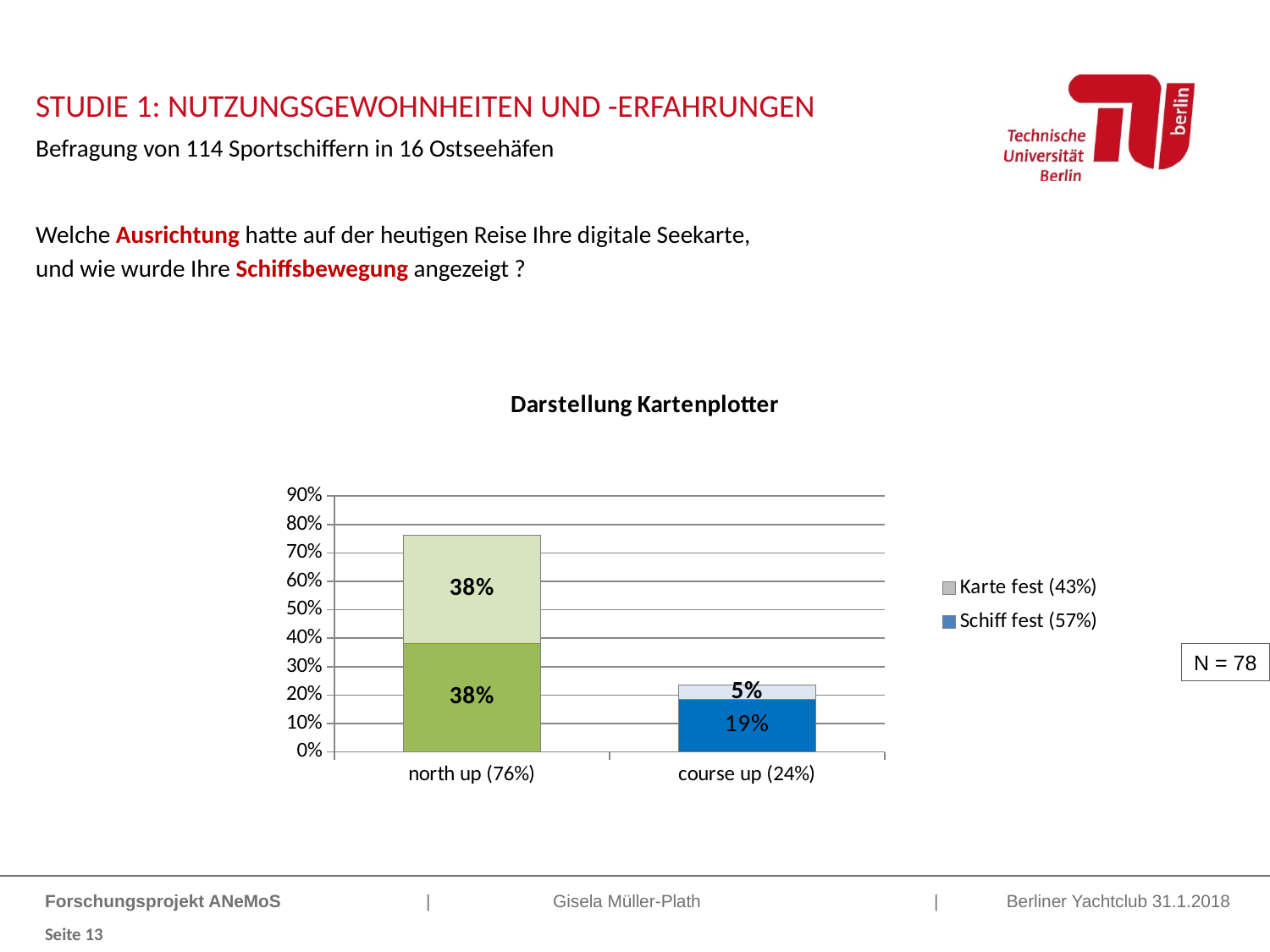
What sample size (N) is stated next to the chart? N = 78 What is the value of the "Schiff fest" segment for "course up"? 19% How many categories are shown on the x axis? 2 What is the value of the "Karte fest" segment for "north up"? 38% What is the total of the stacked bar for "course up"? 24% How many series does the legend list? 2 What type of chart is shown under the title "Darstellung Kartenplotter"? stacked bar chart What is the value of the "Karte fest" segment for "course up"? 5% Which category has the taller stacked bar, "north up" or "course up"? north up What is the total of the stacked bar for "north up"? 76% What is the value of the "Schiff fest" segment for "north up"? 38% What is the difference between the "Schiff fest" values for "north up" and "course up"? 19%